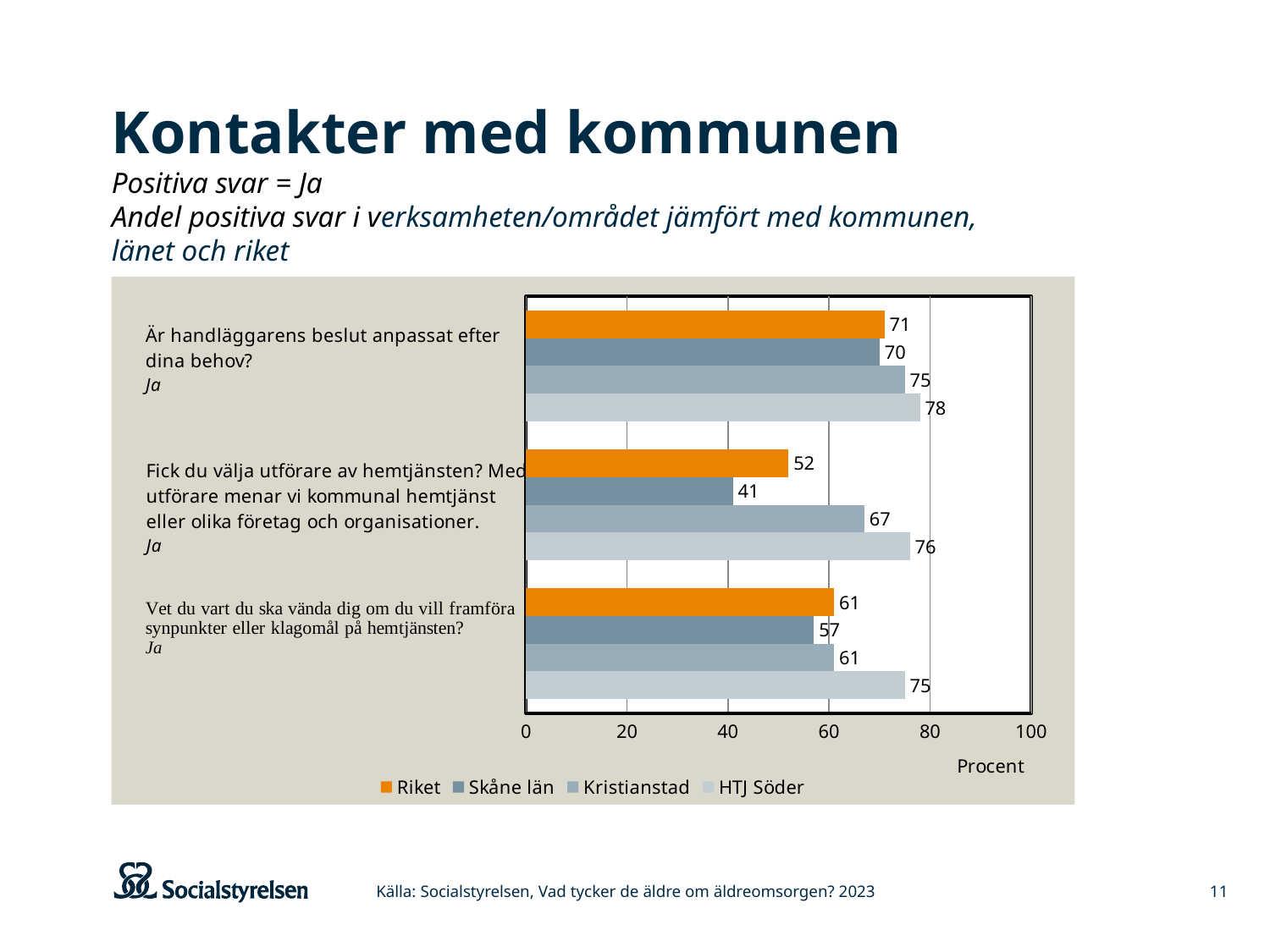
What is the value for HTJ Söder on the question "Är handläggarens beslut anpassat efter dina behov?"? 78 What is the value for Skåne län on the question "Fick du välja utförare av hemtjänsten?"? 41 Which series has the lowest value on the question "Fick du välja utförare av hemtjänsten?"? Skåne län How many question categories are plotted on the chart? 3 What unit label is shown on the x axis of the chart? Procent Which series has the highest value on the question "Vet du vart du ska vända dig om du vill framföra synpunkter eller klagomål på hemtjänsten?"? HTJ Söder How many series does the legend list? 4 What is the difference between HTJ Söder and Skåne län on the question "Fick du välja utförare av hemtjänsten?"? 35 Which is larger on the question "Är handläggarens beslut anpassat efter dina behov?": Kristianstad or Riket? Kristianstad What type of chart is shown on the slide? Bar chart Is the value for Riket on the question "Fick du välja utförare av hemtjänsten?" greater or less than 60? less What is the value for Riket on the question "Vet du vart du ska vända dig om du vill framföra synpunkter eller klagomål på hemtjänsten?"? 61